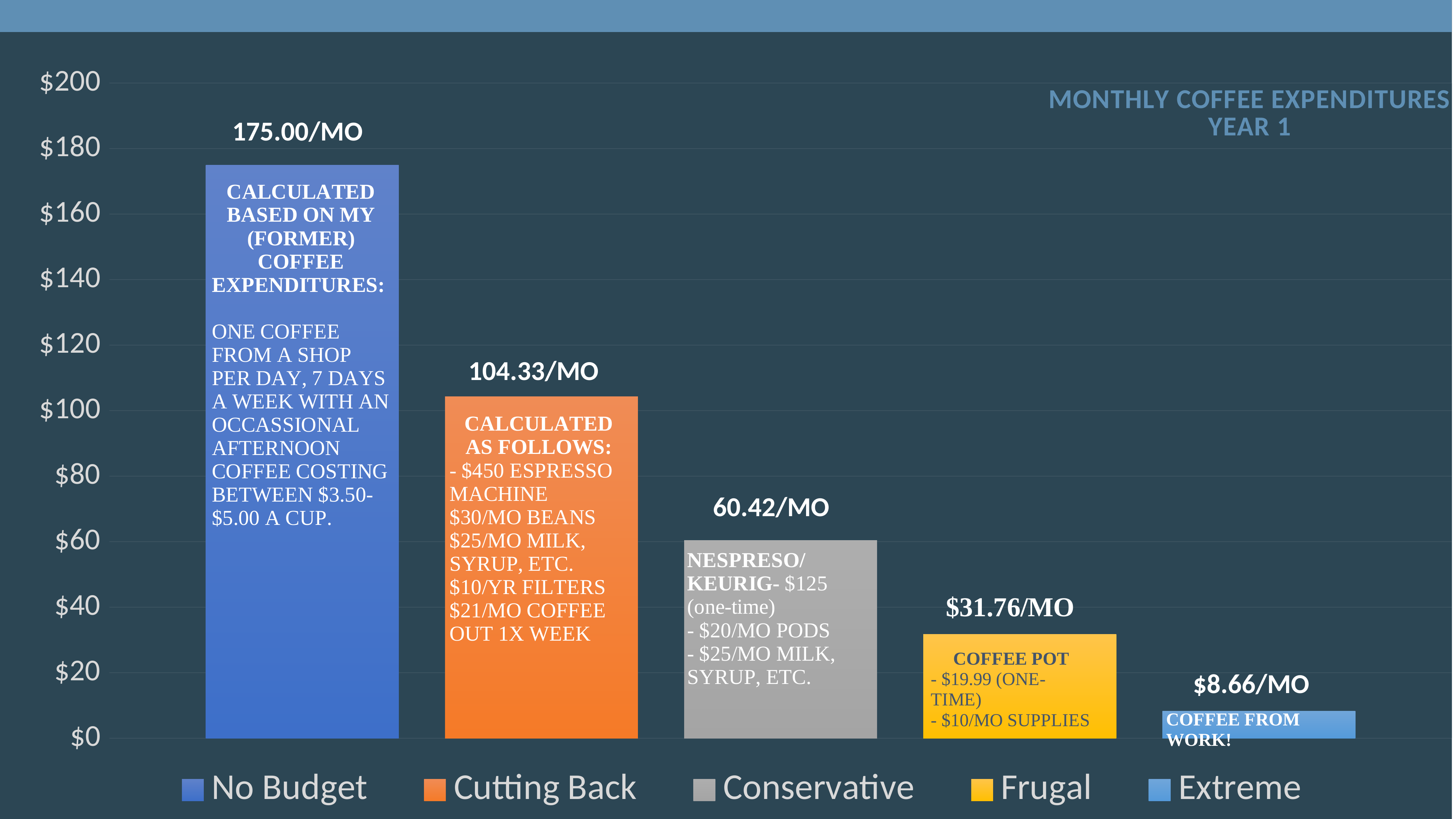
What is the value shown for the Extreme bar? $8.66/MO Is the value for Cutting Back greater or less than $100? greater What is the value shown for the No Budget bar? 175.00/MO Which is larger, the Conservative value or the Frugal value? Conservative What is the value shown for the Cutting Back bar? 104.33/MO How many categories does the legend list? 5 What is the value shown for the Conservative bar? 60.42/MO What is the value shown for the Frugal bar? $31.76/MO Do the values rise or fall from left to right across the chart? fall Which category has the lowest monthly coffee expenditure? Extreme What is the difference between the No Budget and Cutting Back values? 70.67/MO Which category has the highest monthly coffee expenditure? No Budget